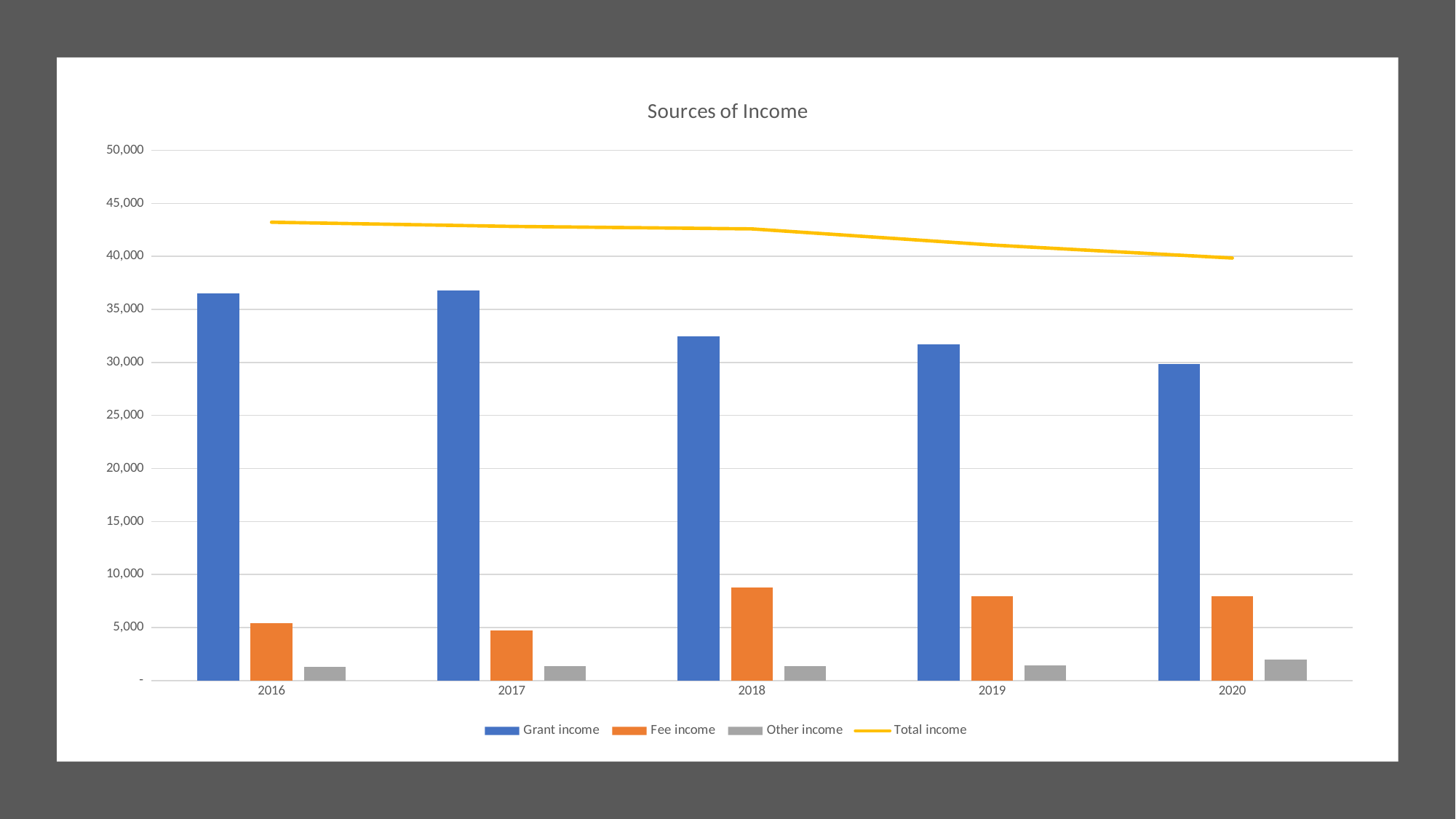
Which year has the lowest Fee income? 2017 Which year has the highest Fee income? 2018 How many series does the legend list? 4 Which year has the lowest Grant income? 2020 What kind of chart is this? bar chart with a line Which year has the highest Other income? 2020 Is the Total income for 2016 greater or less than 40,000? greater How many years are shown on the x axis? 5 Does Total income rise or fall from 2016 to 2020? fall Which is larger in 2019, Fee income or Other income? Fee income What is the title of the chart? Sources of Income Is the Grant income for 2018 greater or less than 30,000? greater